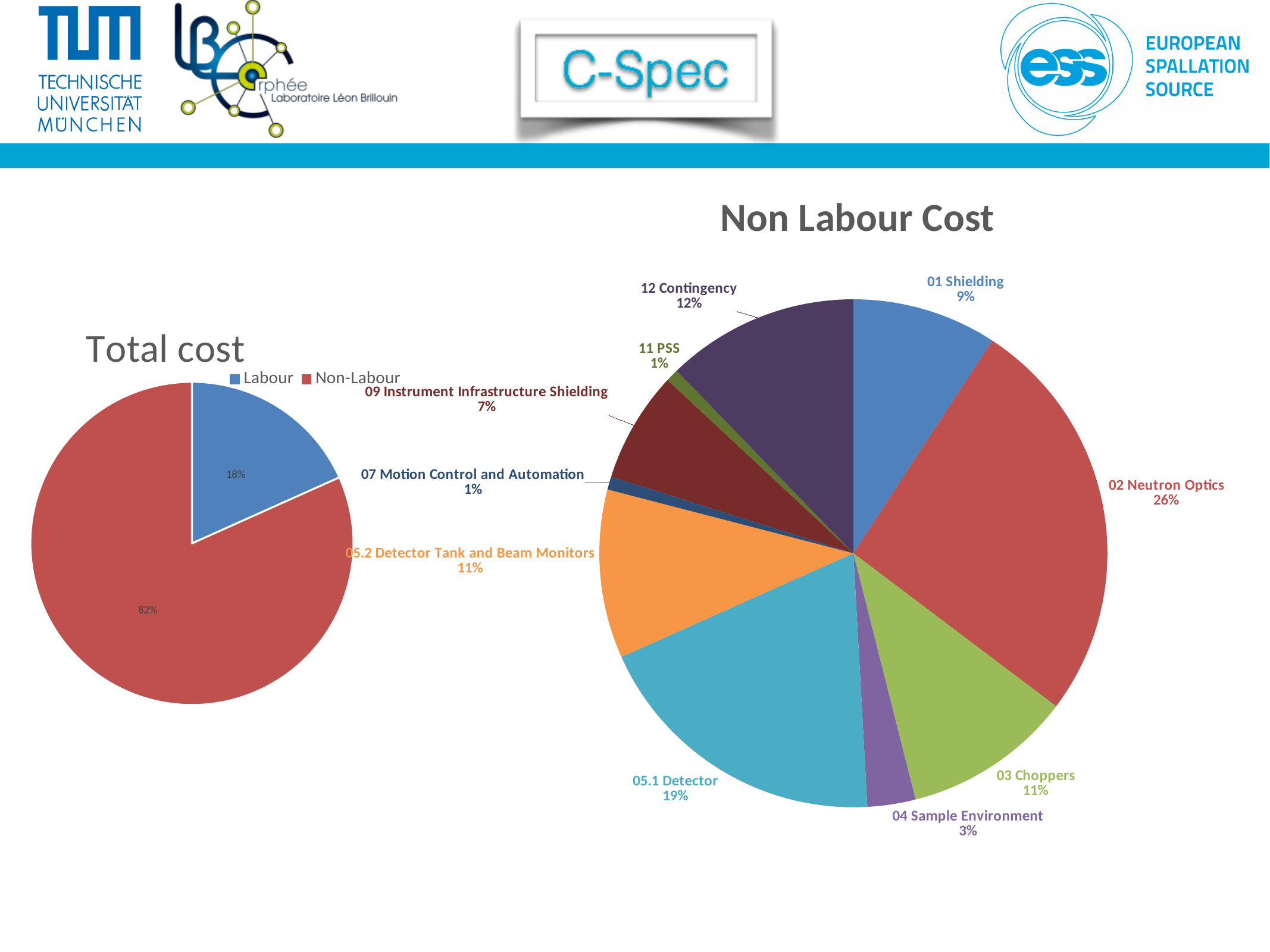
In the Non Labour Cost chart, which category has the largest share? 02 Neutron Optics In the Non Labour Cost chart, what share is 09 Instrument Infrastructure Shielding? 7% What kind of chart is the Total cost chart? Pie chart How many categories are shown in the Non Labour Cost chart? 10 In the Total cost chart, what share of the pie is Non-Labour? 82% In the Non Labour Cost chart, what is the difference in percentage points between 12 Contingency and 01 Shielding? 3% In the Total cost chart, which slice is larger, Labour or Non-Labour? Non-Labour In the Non Labour Cost chart, which is larger, 03 Choppers or 04 Sample Environment? 03 Choppers In the Non Labour Cost chart, what share is 05.1 Detector? 19% How many entries does the legend of the Total cost chart list? 2